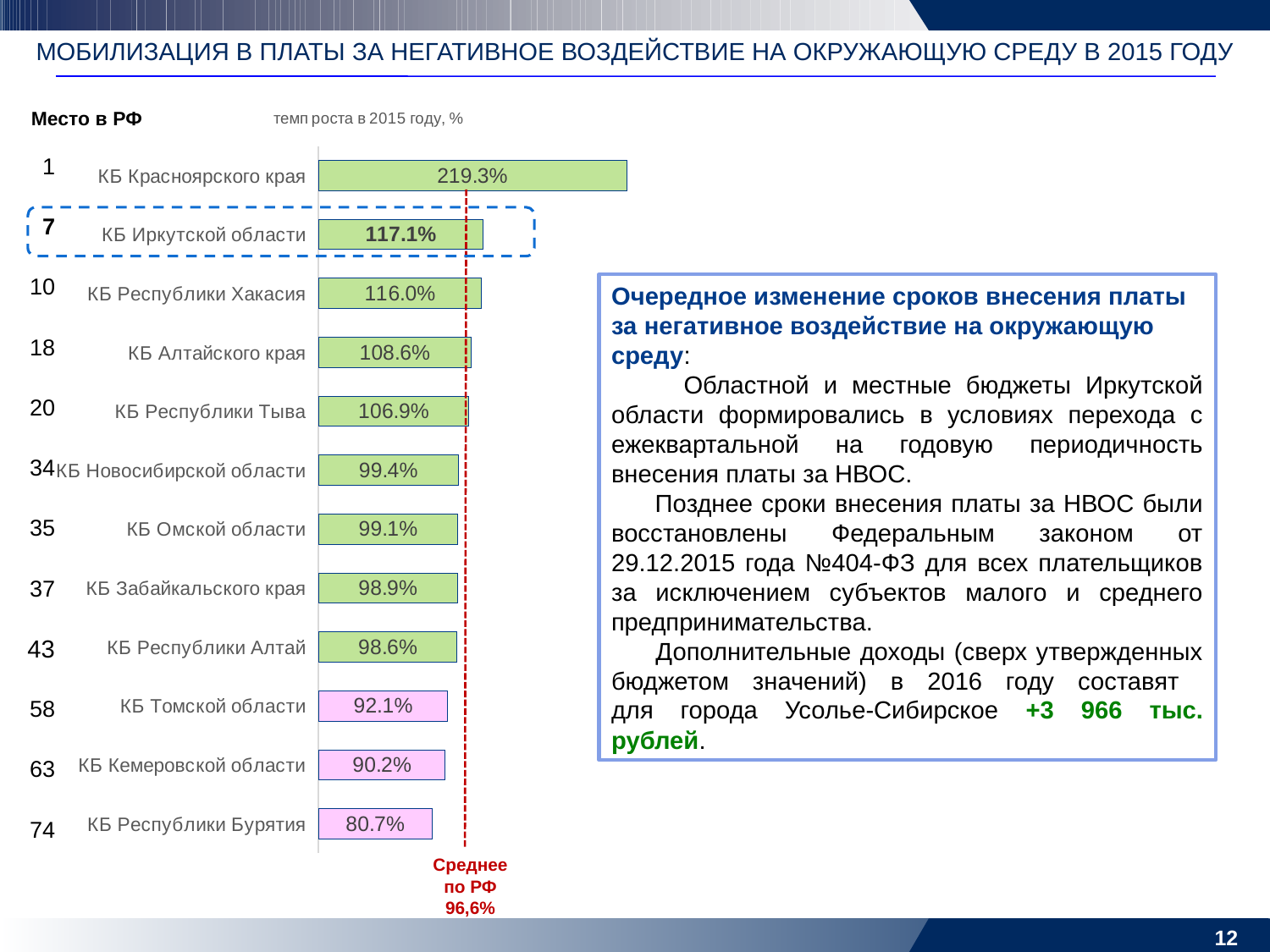
Which category has the lowest growth rate in the chart? КБ Республики Бурятия What is the growth rate shown for КБ Иркутской области? 117.1% What is the growth rate shown for КБ Республики Бурятия? 80.7% Which has a higher growth rate, КБ Алтайского края or КБ Кемеровской области? КБ Алтайского края What is the difference between the growth rates of КБ Красноярского края and КБ Иркутской области? 102.2% What rank in the RF (Место в РФ) is shown for КБ Иркутской области? 7 What type of chart is shown on the slide? Bar chart What is the average growth rate for the Russian Federation marked by the red dashed line? 96,6% Do the growth rates rise or fall going from the top bar to the bottom bar? Fall Which category has the highest growth rate in the chart? КБ Красноярского края How many categories (budgets) are shown in the chart? 12 What is the growth rate shown for КБ Томской области? 92.1%